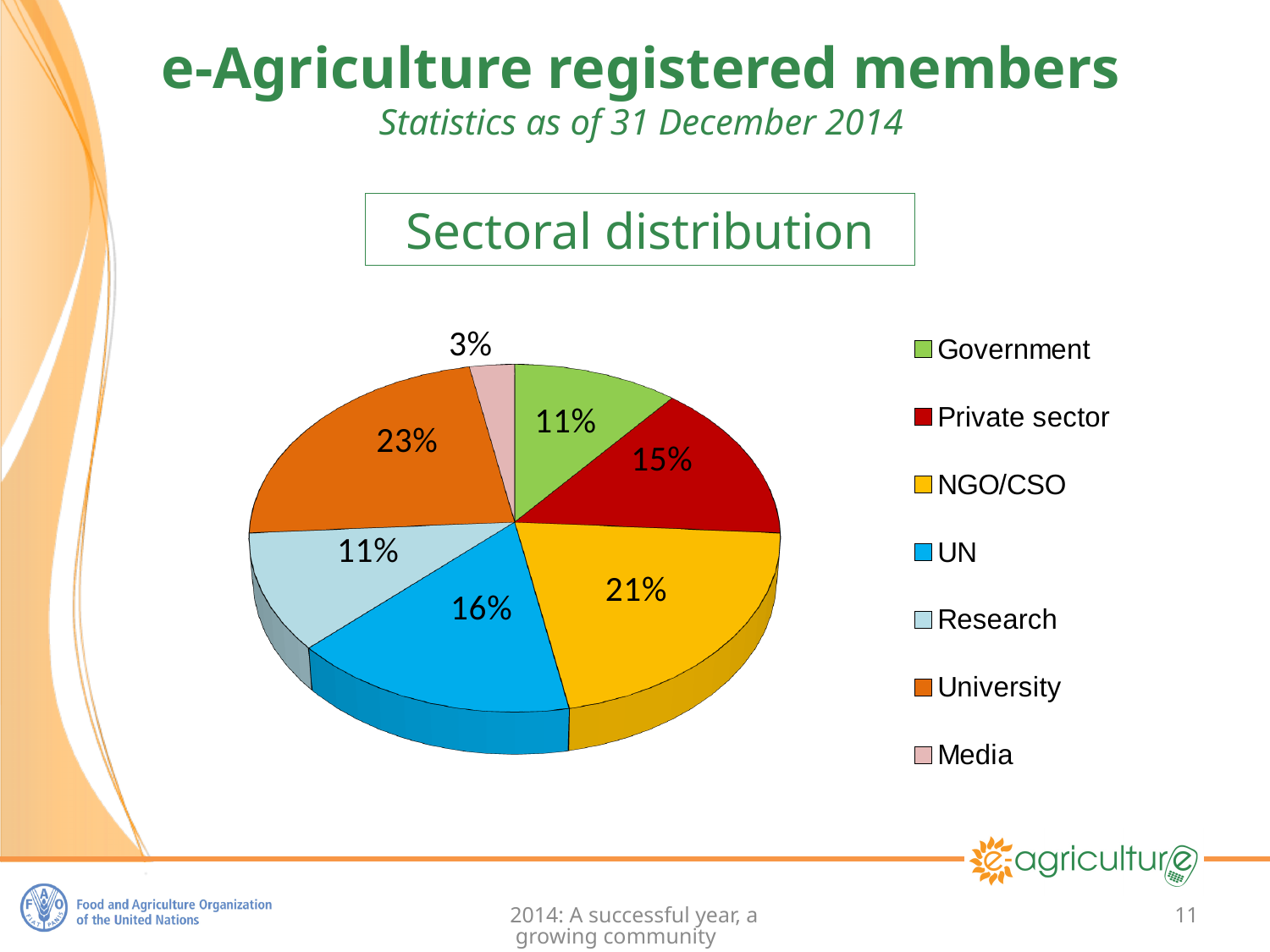
What is the difference in percentage points between the University and NGO/CSO shares? 2 Which sector has the largest share of registered members? University What share of registered members is in the University sector? 23% What share of registered members is in the UN sector? 16% Which sector has the smallest share of registered members? Media What is the title shown above the pie chart? Sectoral distribution What share of registered members is in the NGO/CSO sector? 21% What kind of chart is shown on the slide? pie chart How many sectors does the legend list? 7 Which has a larger share, UN or Private sector? UN